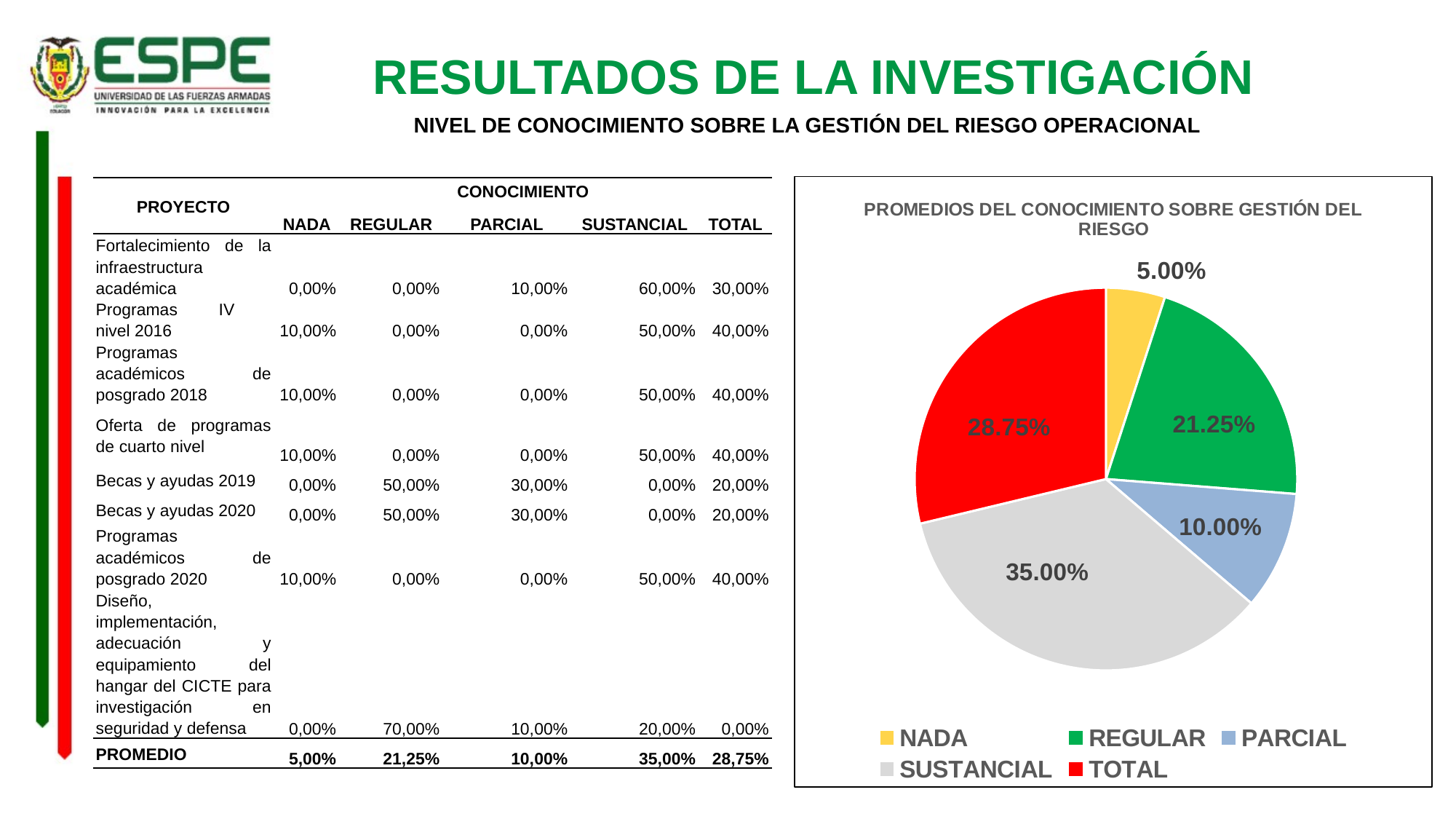
What is the value shown for the SUSTANCIAL slice of the pie chart? 35.00% How many slices does the pie chart have? 5 Which slice is larger in the pie chart, REGULAR or PARCIAL? REGULAR Which colour is used for the TOTAL slice in the pie chart? red What is the title of the pie chart? PROMEDIOS DEL CONOCIMIENTO SOBRE GESTIÓN DEL RIESGO What kind of chart is shown on the slide? pie chart What is the value shown for the NADA slice of the pie chart? 5.00% What is the difference between the SUSTANCIAL and TOTAL slices in the pie chart? 6.25% Which category has the smallest slice in the pie chart? NADA What is the value shown for the REGULAR slice of the pie chart? 21.25% Which category has the largest slice in the pie chart? SUSTANCIAL What is the value shown for the TOTAL slice of the pie chart? 28.75%